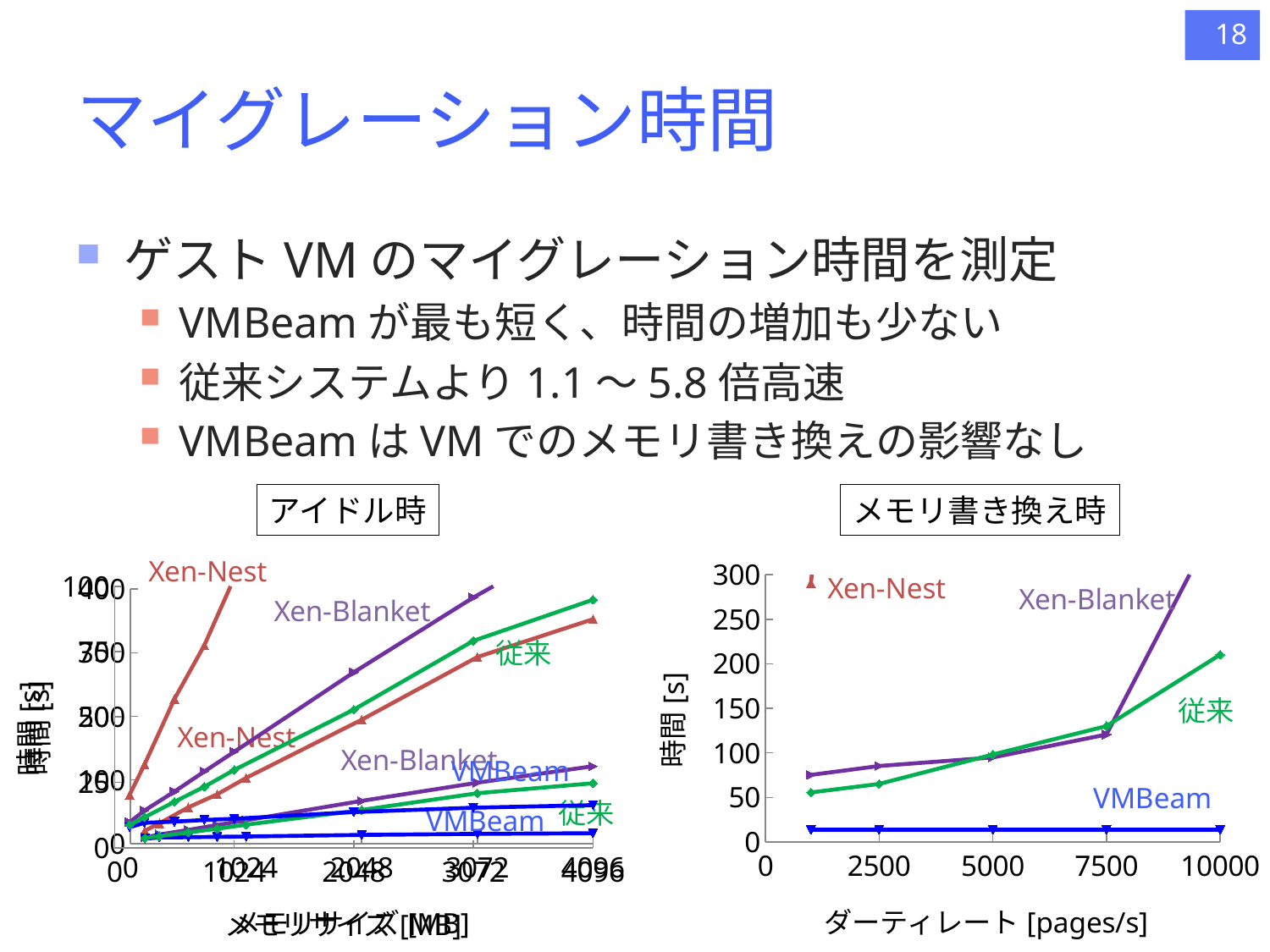
In the chart titled メモリ書き換え時, is the value for VMBeam at 10000 pages/s greater or less than 50? less What kind of chart is the chart titled メモリ書き換え時 on the right? line chart In the chart titled アイドル時 on the left, which series stays lowest across the memory sizes shown? VMBeam In the chart titled メモリ書き換え時, what is the label of the x axis? ダーティレート [pages/s] In the chart titled メモリ書き換え時, at 10000 pages/s, which is larger: 従来 or VMBeam? 従来 In the chart titled メモリ書き換え時, is the value for 従来 at 2500 pages/s greater or less than 100? less In the chart titled メモリ書き換え時, is the value for 従来 at 10000 pages/s greater or less than 150? greater In the chart titled アイドル時 on the left, which series rises most steeply with memory size? Xen-Nest In the chart titled メモリ書き換え時, what is the label of the y axis? 時間 [s] In the chart titled メモリ書き換え時, does the Xen-Blanket line rise or fall as the dirty rate increases? rises In the chart titled メモリ書き換え時, which series has the lowest values across the whole x axis? VMBeam